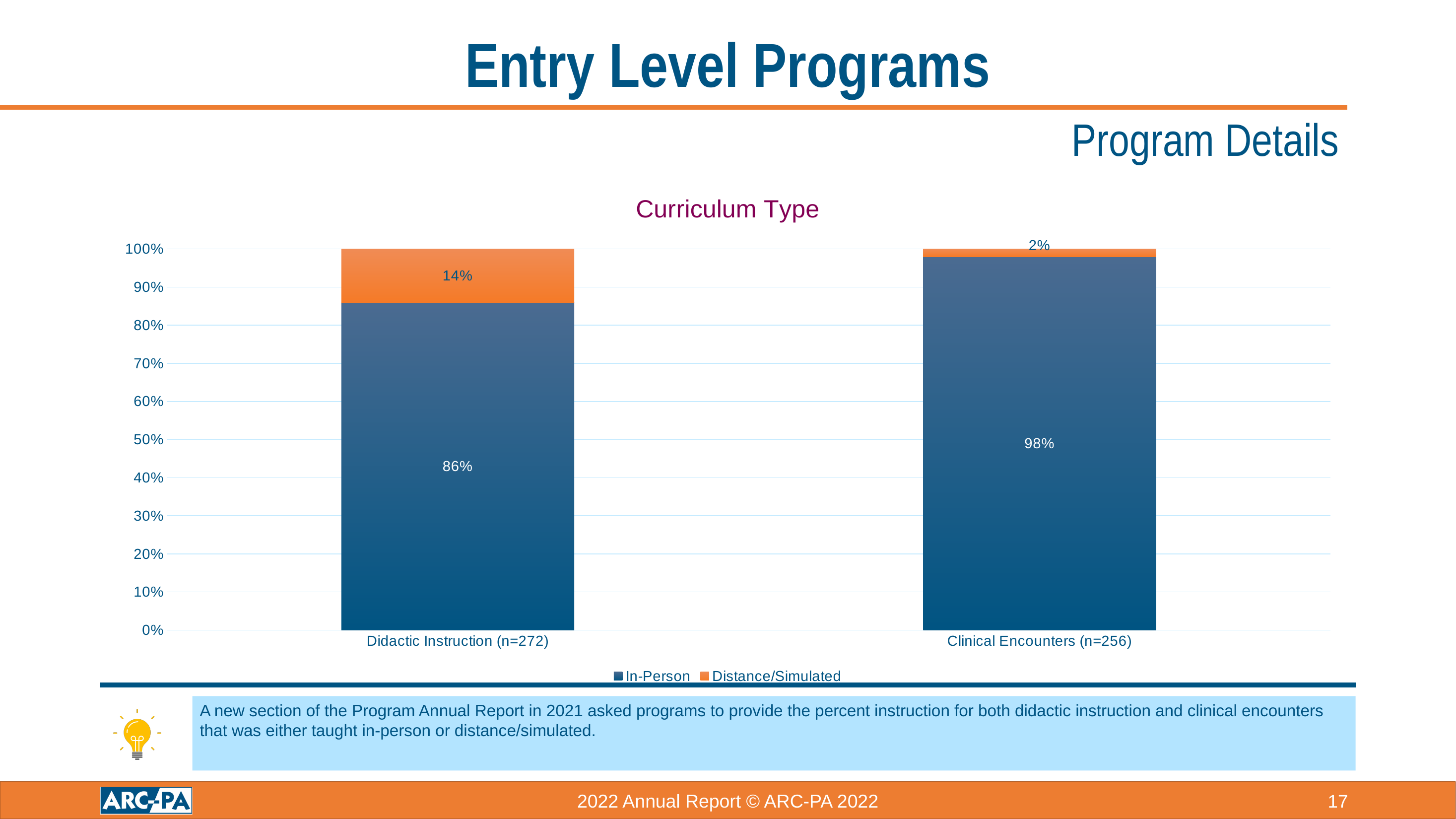
What is the difference between the In-Person values for Clinical Encounters (n=256) and Didactic Instruction (n=272)? 12% How many series does the legend list? 2 What is the In-Person value for Didactic Instruction (n=272)? 86% Which category has the higher In-Person share? Clinical Encounters (n=256) What is the Distance/Simulated value for Clinical Encounters (n=256)? 2% What is the Distance/Simulated value for Didactic Instruction (n=272)? 14% How many categories are shown on the x axis? 2 What kind of chart is shown? stacked bar chart What is the title of the chart? Curriculum Type Which category has the lower Distance/Simulated share? Clinical Encounters (n=256) Is the Distance/Simulated value for Didactic Instruction (n=272) larger or smaller than the Distance/Simulated value for Clinical Encounters (n=256)? larger What is the In-Person value for Clinical Encounters (n=256)? 98%